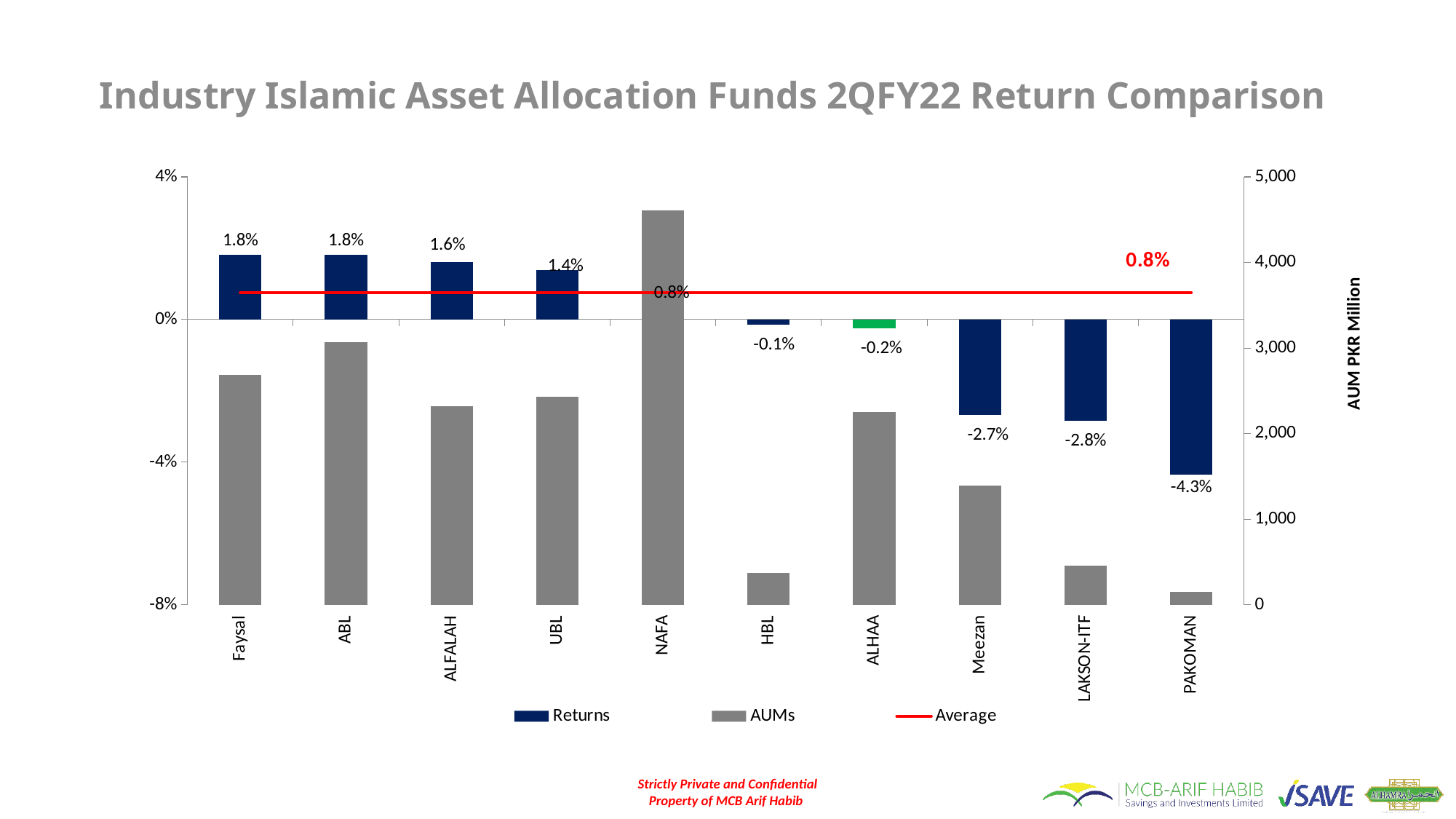
How many series does the legend list? 3 What is the return for ALFALAH? 1.6% Is the AUM for NAFA greater or less than 4,000? greater What is the return for PAKOMAN? -4.3% What is the return for HBL? -0.1% Which fund has the highest AUM? NAFA What is the difference between the returns of Meezan and PAKOMAN? 1.6 percentage points How many funds are shown on the x axis? 10 Which has the higher return, ALFALAH or UBL? ALFALAH What is the value of the Average line? 0.8% Which fund has the lowest return? PAKOMAN Is the AUM for HBL greater or less than 1,000? less